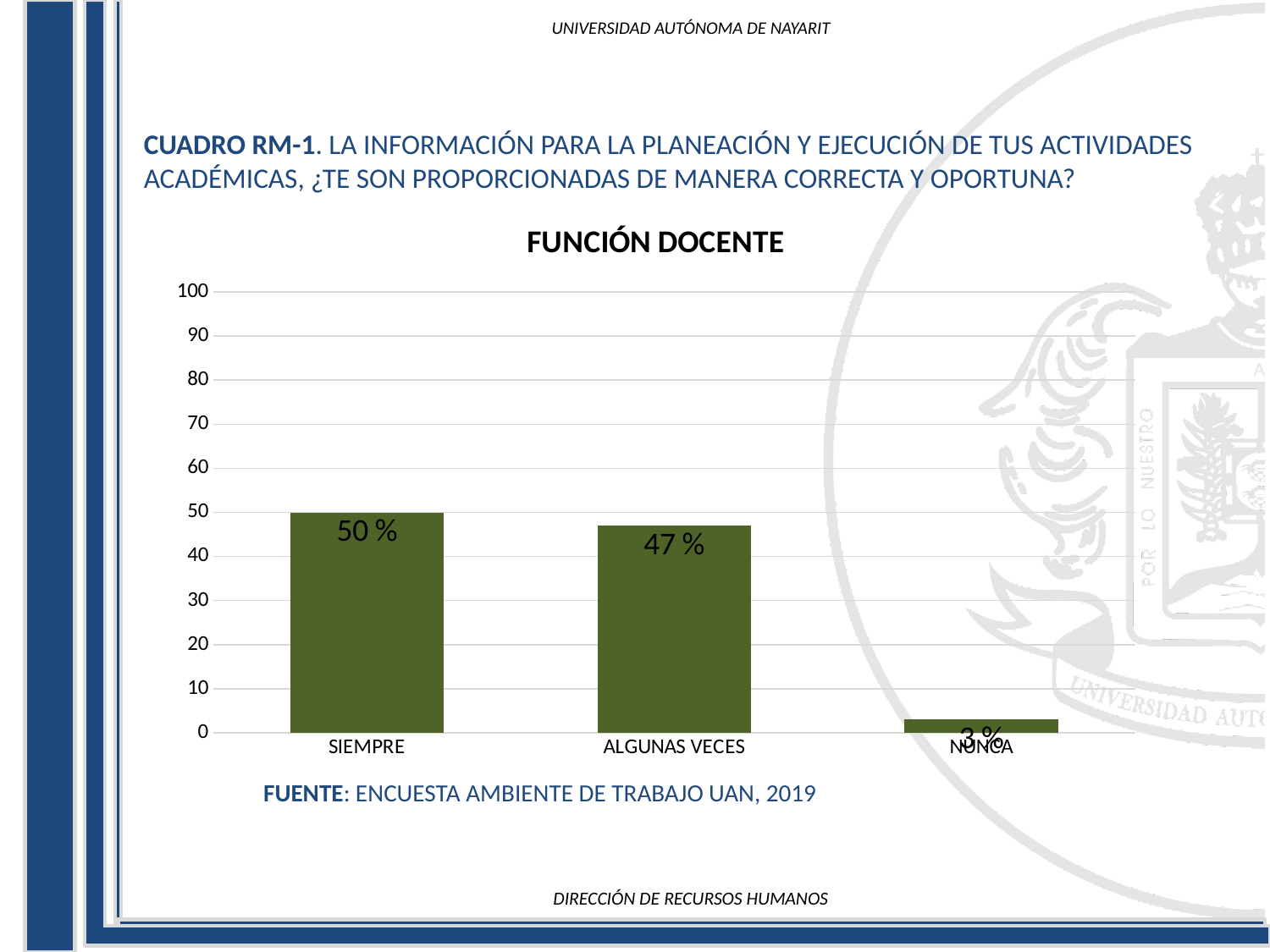
What is the difference between the values for ALGUNAS VECES and NUNCA? 44 % Which category has the lowest value? NUNCA How many categories are shown on the x axis? 3 What is the difference between the values for SIEMPRE and ALGUNAS VECES? 3 % Is the value for ALGUNAS VECES greater or less than 50? less Which is larger, the value for ALGUNAS VECES or the value for NUNCA? ALGUNAS VECES What is the value for SIEMPRE? 50 % What is the title of the chart? FUNCIÓN DOCENTE Which category has the highest value? SIEMPRE What is the value for NUNCA? 3 % What is the value for ALGUNAS VECES? 47 % What kind of chart is shown? bar chart